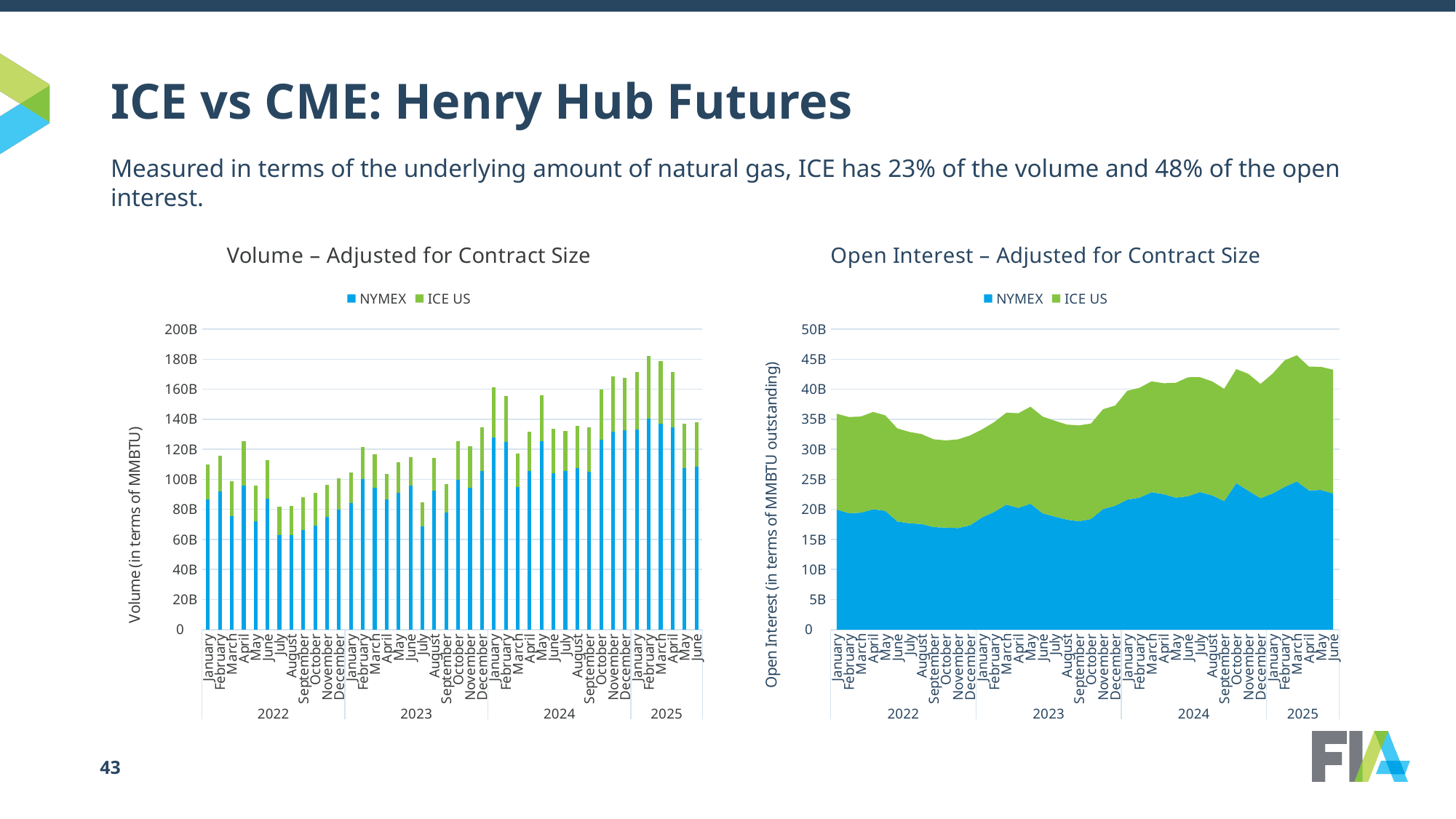
How many years are labelled on the x axis of the 'Volume – Adjusted for Contract Size' chart? 4 In the 'Open Interest – Adjusted for Contract Size' chart, which series is shown in green? ICE US In the 'Volume – Adjusted for Contract Size' chart, is the total bar for January 2024 greater or less than 140B? greater In the 'Open Interest – Adjusted for Contract Size' chart, is the total open interest in October 2022 greater or less than 35B? less In the 'Open Interest – Adjusted for Contract Size' chart, does total open interest generally rise or fall from 2022 to 2025? rise How many series does the legend of the 'Volume – Adjusted for Contract Size' chart list? 2 In the 'Volume – Adjusted for Contract Size' chart, is the total bar for February 2025 greater or less than 160B? greater What kind of chart is the 'Open Interest – Adjusted for Contract Size' chart? stacked area chart What kind of chart is the 'Volume – Adjusted for Contract Size' chart? bar chart What is the highest tick value on the y axis of the 'Open Interest – Adjusted for Contract Size' chart? 50B